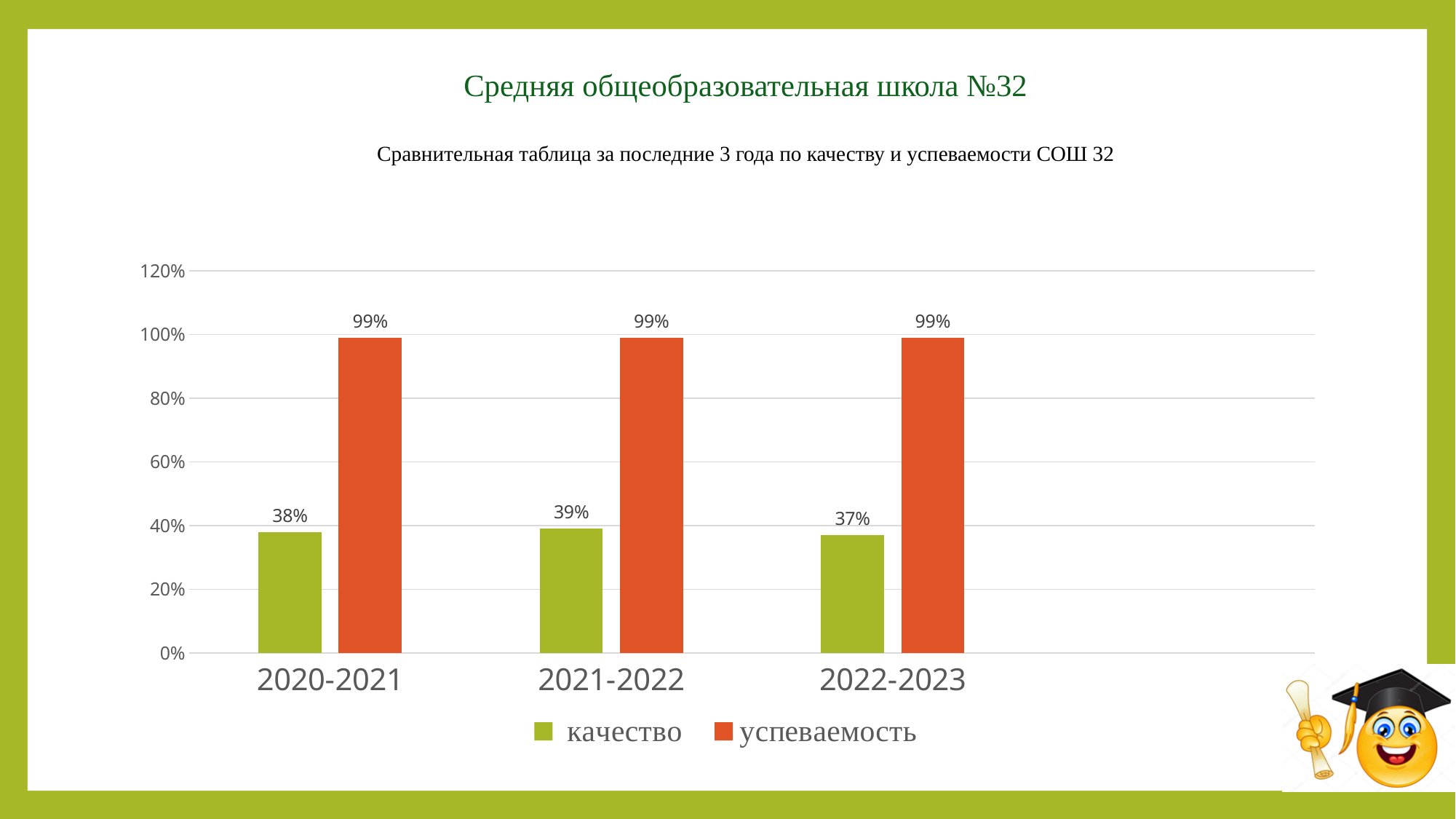
How many year categories are shown on the x axis? 3 Which is larger in 2022-2023: качество or успеваемость? успеваемость What kind of chart is shown on the slide? bar chart What is the difference between успеваемость and качество in 2020-2021? 61% What is the value of успеваемость for 2021-2022? 99% What is the difference between качество in 2021-2022 and качество in 2022-2023? 2% How many series does the legend list? 2 What is the value of качество for 2022-2023? 37% What is the value of качество for 2021-2022? 39% What is the value of качество for 2020-2021? 38% In which year is качество the highest? 2021-2022 In which year is качество the lowest? 2022-2023